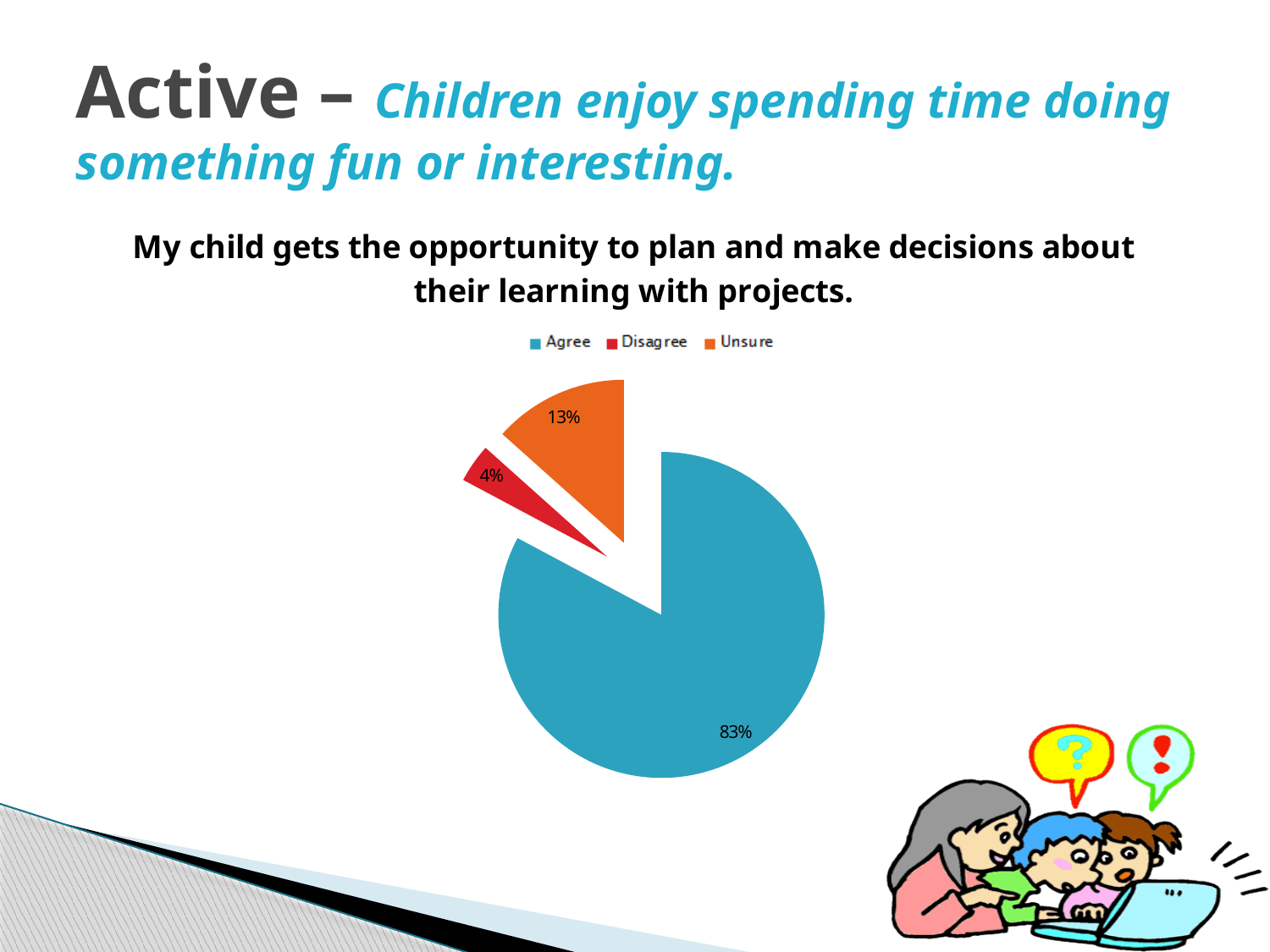
What percentage of respondents chose Unsure? 13% What percentage of respondents chose Agree? 83% What colour is the Agree slice? blue What is the difference in percentage points between Unsure and Disagree? 9 Which response has the smallest share of the pie? Disagree What kind of chart is shown on the slide? pie chart What percentage of respondents chose Disagree? 4% What colour is the Unsure slice? orange How many categories does the legend list? 3 Which is larger, the share for Unsure or the share for Disagree? Unsure What is the difference in percentage points between Agree and Unsure? 70 Which response has the largest share of the pie? Agree